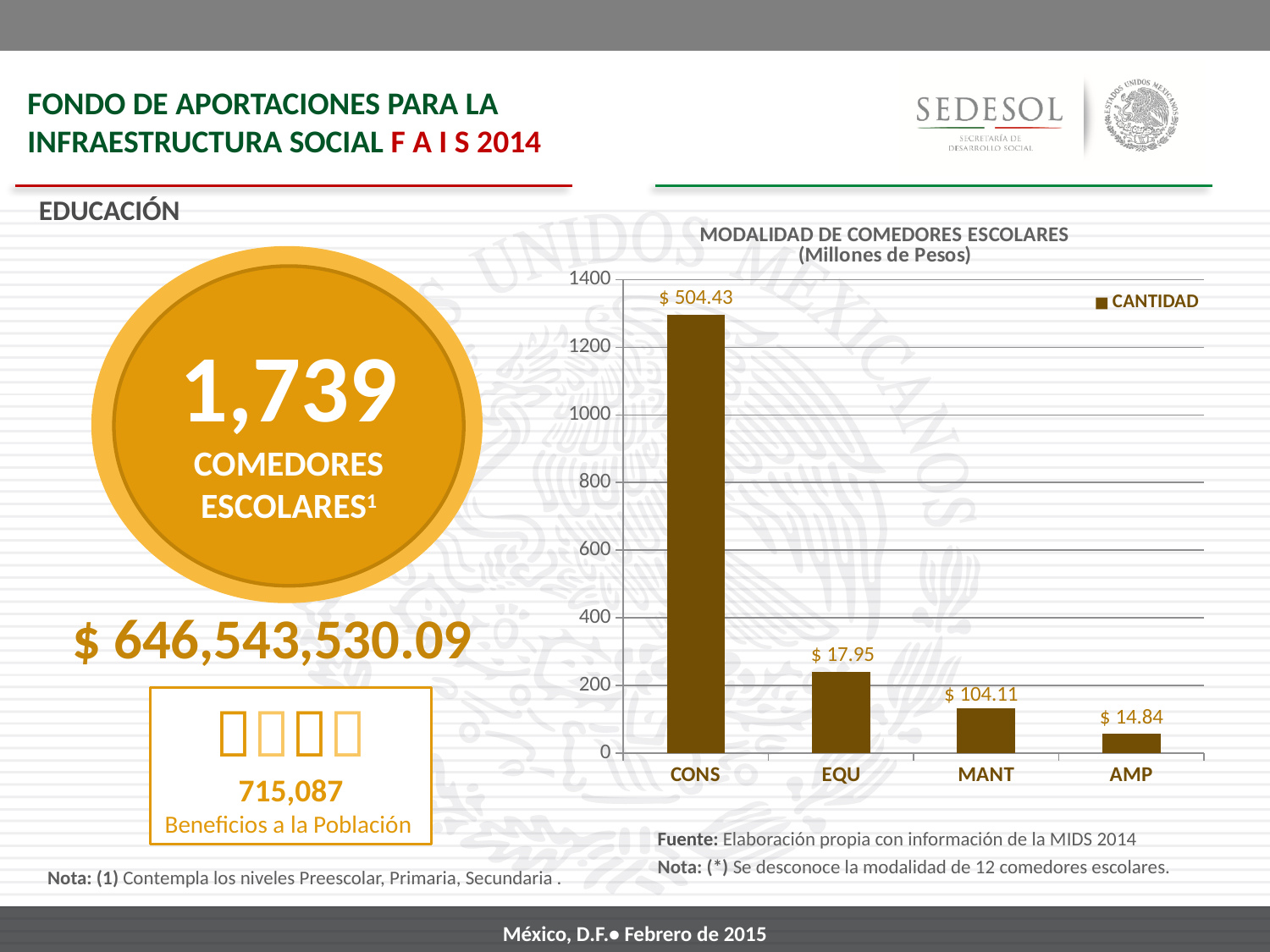
What value is labelled on the EQU bar in the chart? $ 17.95 Is the value for AMP greater or less than 200? less Which is larger, the value for CONS or the value for AMP? CONS Which category has the highest value in the chart? CONS What is the difference between the labelled values for CONS and AMP? $ 489.59 What value is labelled on the MANT bar in the chart? $ 104.11 What value is labelled on the CONS bar in the chart? $ 504.43 What kind of chart is shown on the slide? bar chart How many series does the chart legend list? 1 Which category has the lowest value in the chart? AMP How many categories are shown on the x axis of the chart? 4 What value is labelled on the AMP bar in the chart? $ 14.84